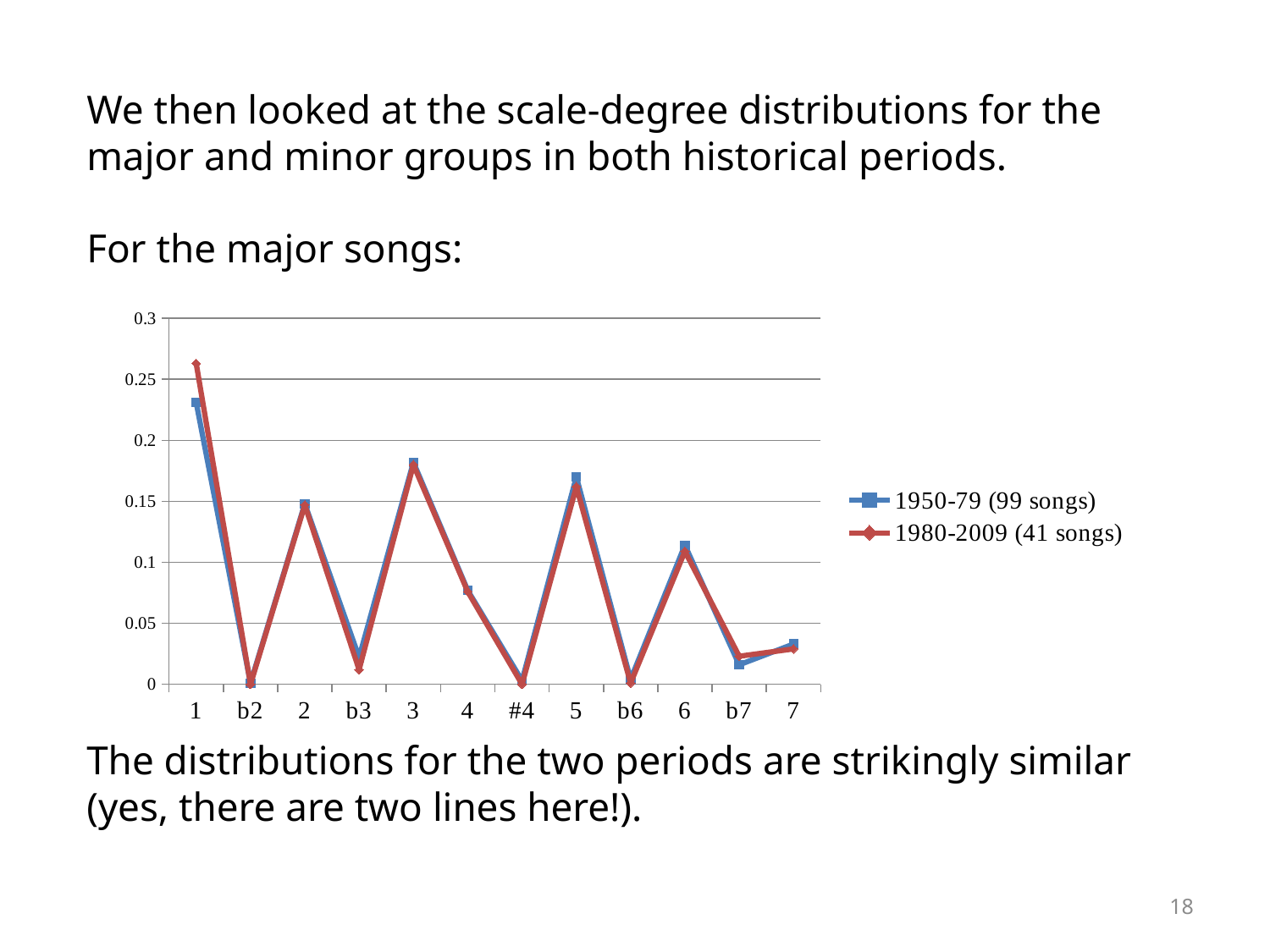
What are the two legend entries of the chart? 1950-79 (99 songs) and 1980-2009 (41 songs) Is the value for scale degree 1 in the 1950-79 (99 songs) series greater or less than 0.2? greater Which scale degree has the highest value for the 1980-2009 (41 songs) series? 1 Is the value for scale degree 3 in the 1980-2009 (41 songs) series greater or less than 0.15? greater In the 1980-2009 (41 songs) series, which is larger, the value for scale degree 3 or for scale degree 5? scale degree 3 How many series does the legend list? 2 Is the value for scale degree 4 in the 1950-79 (99 songs) series greater or less than 0.1? less How many scale-degree categories are plotted along the x axis? 12 Which scale degree has the highest value for the 1950-79 (99 songs) series? 1 What kind of chart is shown on the slide? line chart For scale degree 1, which series has the larger value, 1950-79 (99 songs) or 1980-2009 (41 songs)? 1980-2009 (41 songs)